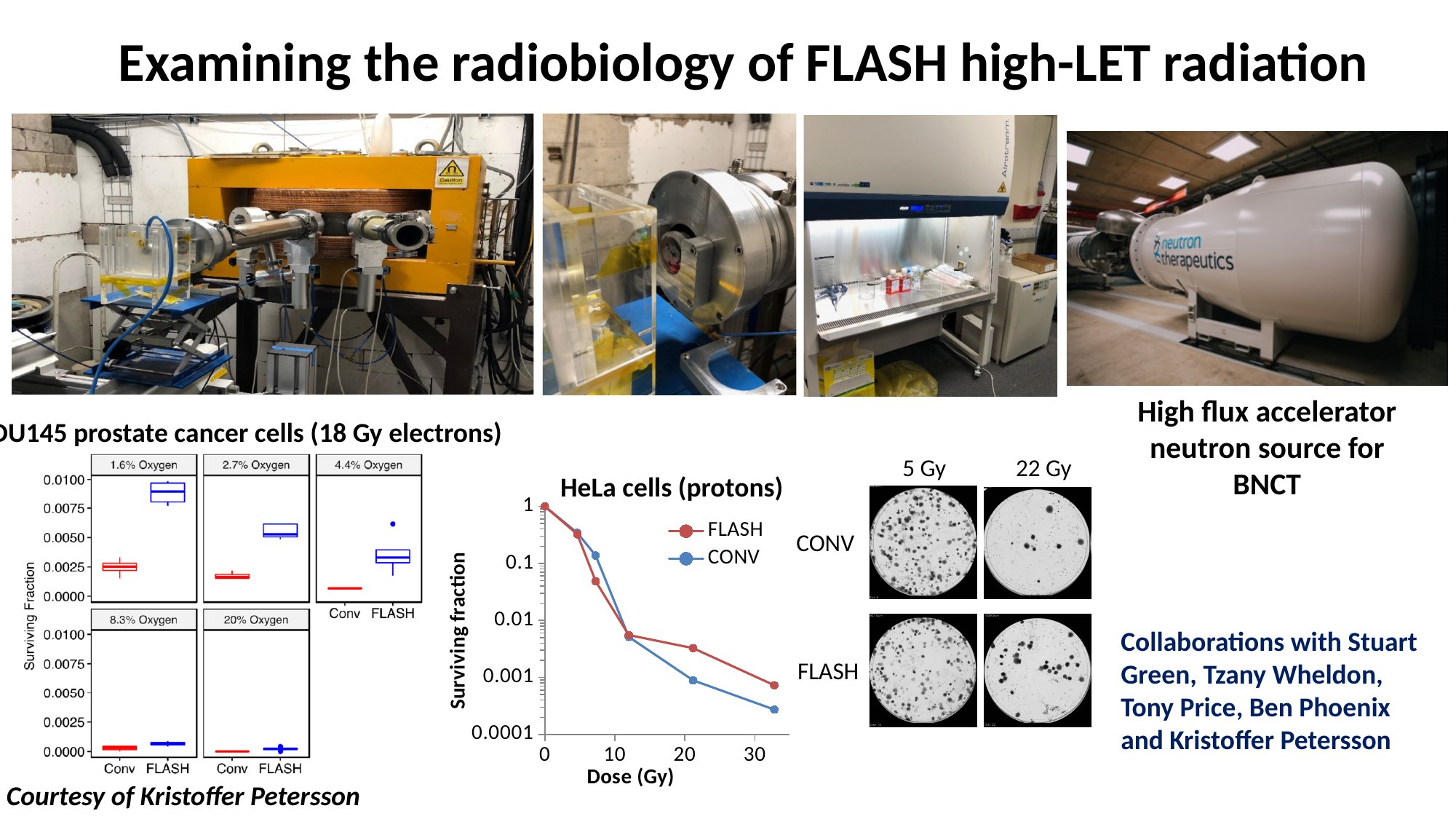
In the 'HeLa cells (protons)' chart, at the highest dose plotted, which series has the larger surviving fraction, FLASH or CONV? FLASH What are the two series named in the legend of the 'HeLa cells (protons)' chart? FLASH and CONV In the 1.6% Oxygen panel of the 'DU145 prostate cancer cells (18 Gy electrons)' chart, is the FLASH median surviving fraction greater or less than 0.0075? greater In the 'HeLa cells (protons)' chart, is the FLASH surviving fraction at about 21 Gy greater or less than 0.001? greater In the 'HeLa cells (protons)' chart, does the surviving fraction rise or fall as dose increases? fall In the 'DU145 prostate cancer cells (18 Gy electrons)' chart, which oxygen level shows the highest FLASH surviving fraction? 1.6% Oxygen What kind of chart is the 'HeLa cells (protons)' chart? line chart How many series does the legend of the 'HeLa cells (protons)' chart list? 2 How many oxygen-level panels are shown in the 'DU145 prostate cancer cells (18 Gy electrons)' chart? 5 In the 1.6% Oxygen panel of the 'DU145 prostate cancer cells (18 Gy electrons)' chart, which condition has the larger surviving fraction, Conv or FLASH? FLASH In the 'HeLa cells (protons)' chart, is the CONV surviving fraction at the highest dose greater or less than 0.001? less In the 'HeLa cells (protons)' chart, what is the label of the x axis? Dose (Gy)